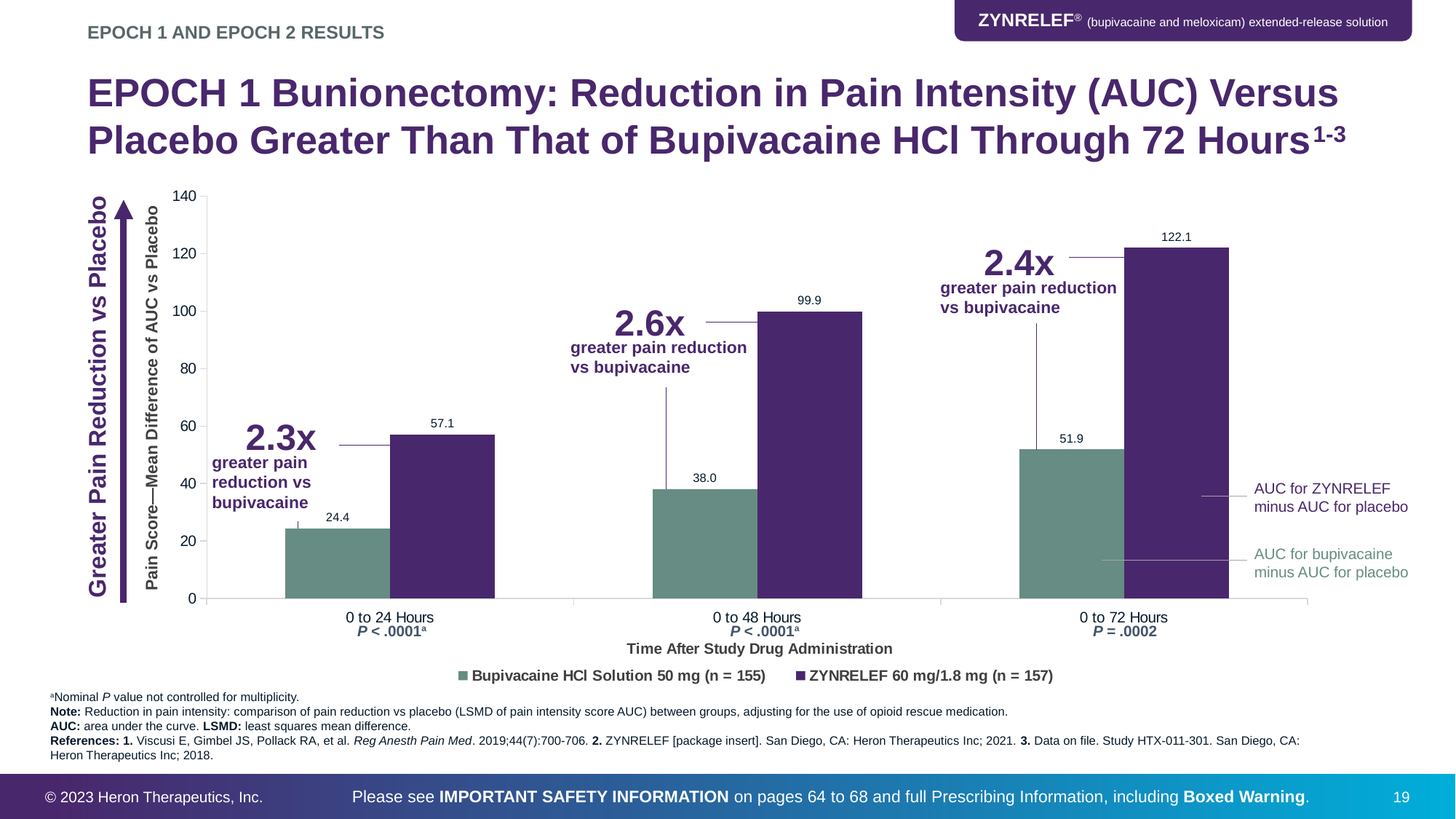
How many time periods are shown on the x axis? 3 What is the value for Bupivacaine HCl Solution 50 mg at 0 to 24 Hours? 24.4 What is the difference between the ZYNRELEF and Bupivacaine HCl values at 0 to 48 Hours? 61.9 At which time period is the Bupivacaine HCl Solution 50 mg value lowest? 0 to 24 Hours At which time period is the ZYNRELEF 60 mg/1.8 mg value highest? 0 to 72 Hours What is the value for ZYNRELEF 60 mg/1.8 mg at 0 to 24 Hours? 57.1 How many series does the legend list? 2 What is the value for Bupivacaine HCl Solution 50 mg at 0 to 48 Hours? 38.0 What kind of chart is shown on the slide? Bar chart Which is larger at 0 to 72 Hours: the ZYNRELEF value or the Bupivacaine HCl value? ZYNRELEF 60 mg/1.8 mg Do the ZYNRELEF 60 mg/1.8 mg values rise or fall from 0 to 24 Hours to 0 to 72 Hours? Rise What is the value for ZYNRELEF 60 mg/1.8 mg at 0 to 72 Hours? 122.1